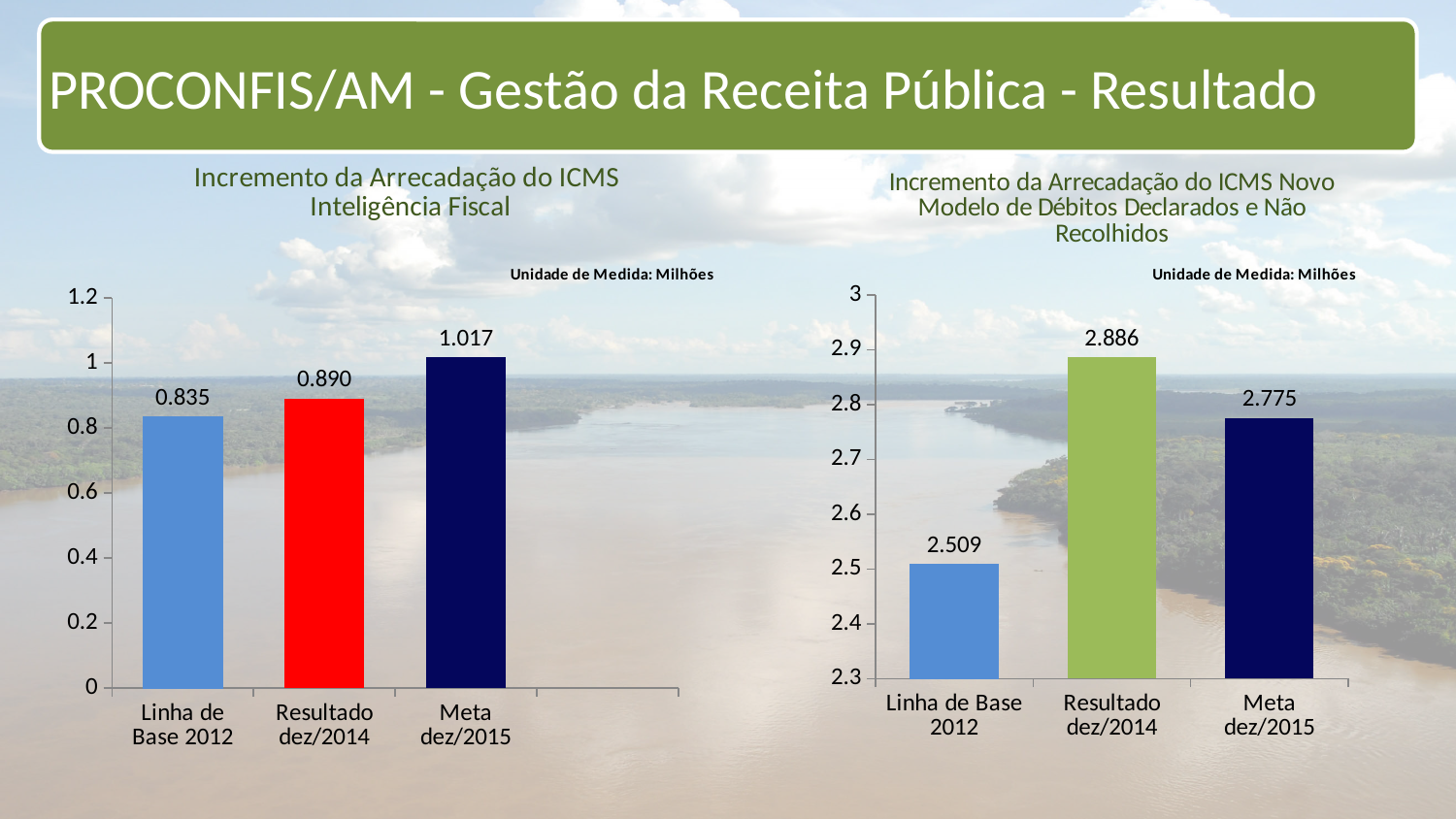
In the right chart (Novo Modelo de Débitos Declarados e Não Recolhidos), what is the value for Linha de Base 2012? 2.509 In the right chart (Novo Modelo de Débitos Declarados e Não Recolhidos), which category has the highest value? Resultado dez/2014 In the left chart (Inteligência Fiscal), which category has the lowest value? Linha de Base 2012 In the left chart (Inteligência Fiscal), do the values rise or fall from Linha de Base 2012 to Meta dez/2015? rise In the right chart (Novo Modelo de Débitos Declarados e Não Recolhidos), which is larger: Resultado dez/2014 or Meta dez/2015? Resultado dez/2014 In the right chart (Novo Modelo de Débitos Declarados e Não Recolhidos), what is the value for Resultado dez/2014? 2.886 In the right chart (Novo Modelo de Débitos Declarados e Não Recolhidos), what is the difference between Resultado dez/2014 and Meta dez/2015? 0.111 In the left chart (Inteligência Fiscal), what is the value for Meta dez/2015? 1.017 In the left chart (Inteligência Fiscal), what is the difference between Meta dez/2015 and Linha de Base 2012? 0.182 How many categories are shown in the left chart (Inteligência Fiscal)? 3 In the left chart (Inteligência Fiscal), what is the value for Linha de Base 2012? 0.835 What type of chart is the right chart (Novo Modelo de Débitos Declarados e Não Recolhidos)? bar chart